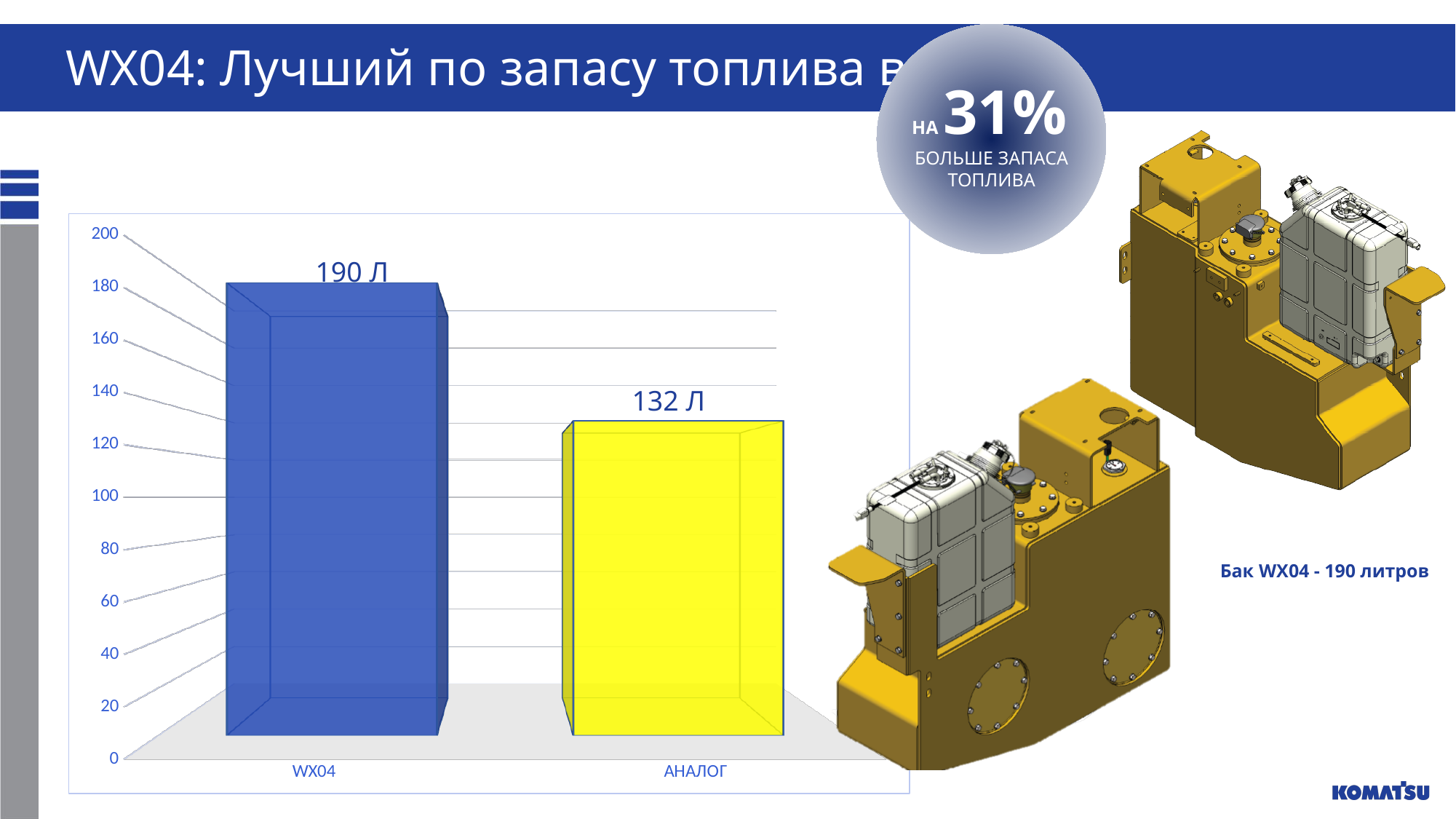
What is the value shown for WX04? 190 Л How many categories are shown on the chart? 2 What is the difference between the values for WX04 and АНАЛОГ? 58 Л Which category has the lowest value? АНАЛОГ Is the value for WX04 greater or less than 180? greater Which category has the highest value? WX04 Is the value for АНАЛОГ greater or less than 140? less What kind of chart is shown on the slide? bar chart What is the value shown for АНАЛОГ? 132 Л What colour is the bar for WX04? blue What is the highest tick value on the vertical axis? 200 Which is larger, the value for WX04 or the value for АНАЛОГ? WX04